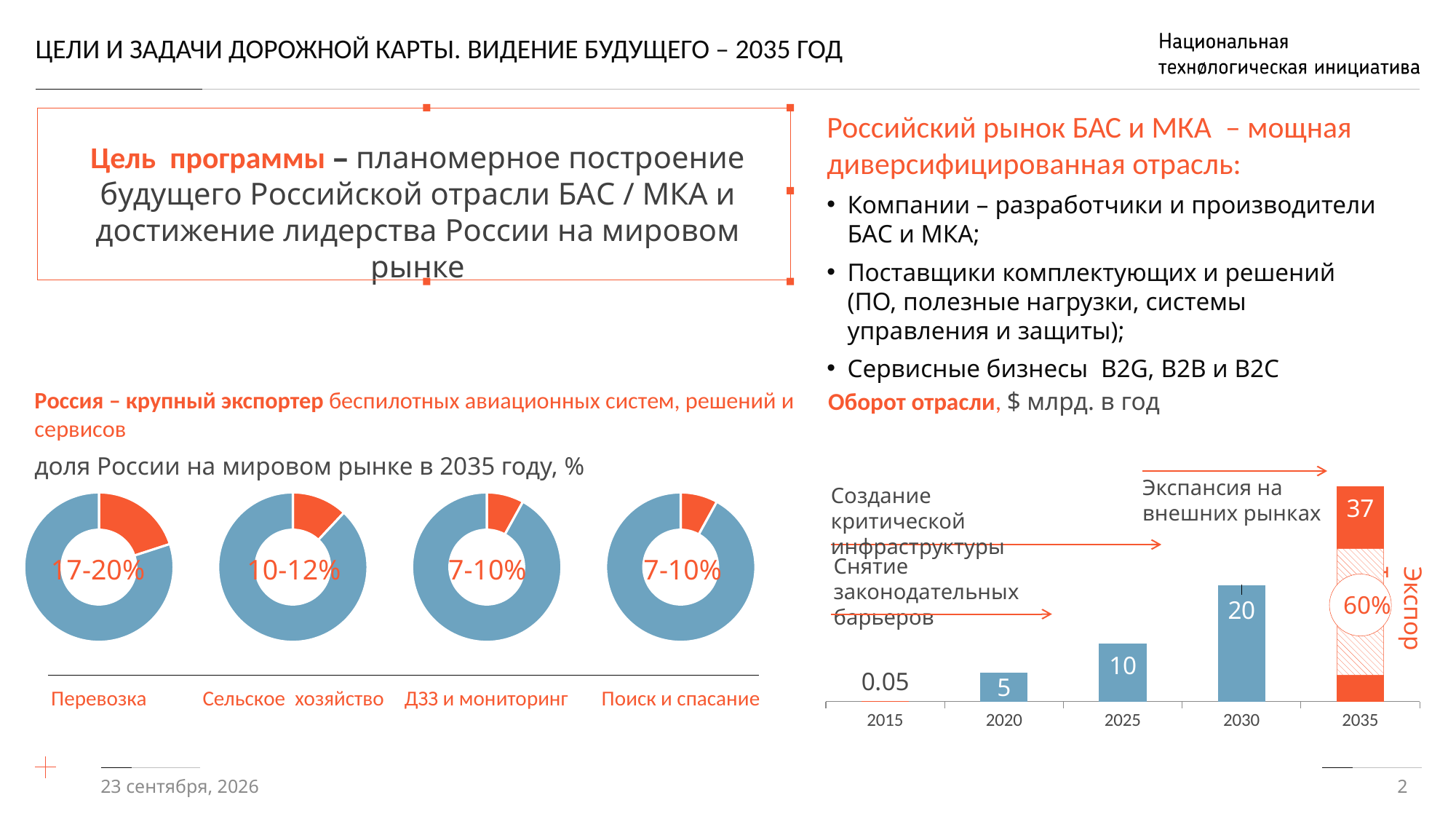
How many donut charts are shown under 'доля России на мировом рынке в 2035 году, %'? 4 In the bar chart 'Оборот отрасли, $ млрд. в год', what is the value for 2015? 0.05 In the bar chart 'Оборот отрасли, $ млрд. в год', what is the value for 2035? 37 In the donut charts 'доля России на мировом рынке в 2035 году, %', what is the value for Перевозка? 17-20% In the bar chart 'Оборот отрасли, $ млрд. в год', how many years are shown on the x axis? 5 In the bar chart 'Оборот отрасли, $ млрд. в год', which year has the highest value? 2035 In the bar chart 'Оборот отрасли, $ млрд. в год', do the values rise or fall from 2015 to 2035? rise In the bar chart 'Оборот отрасли, $ млрд. в год', which year has the lowest value? 2015 In the bar chart 'Оборот отрасли, $ млрд. в год', what export share is marked on the 2035 bar? 60% In the bar chart 'Оборот отрасли, $ млрд. в год', what is the difference between the values for 2030 and 2025? 10 In the donut charts 'доля России на мировом рынке в 2035 году, %', what is the value for Сельское хозяйство? 10-12% In the bar chart 'Оборот отрасли, $ млрд. в год', what is the value for 2020? 5